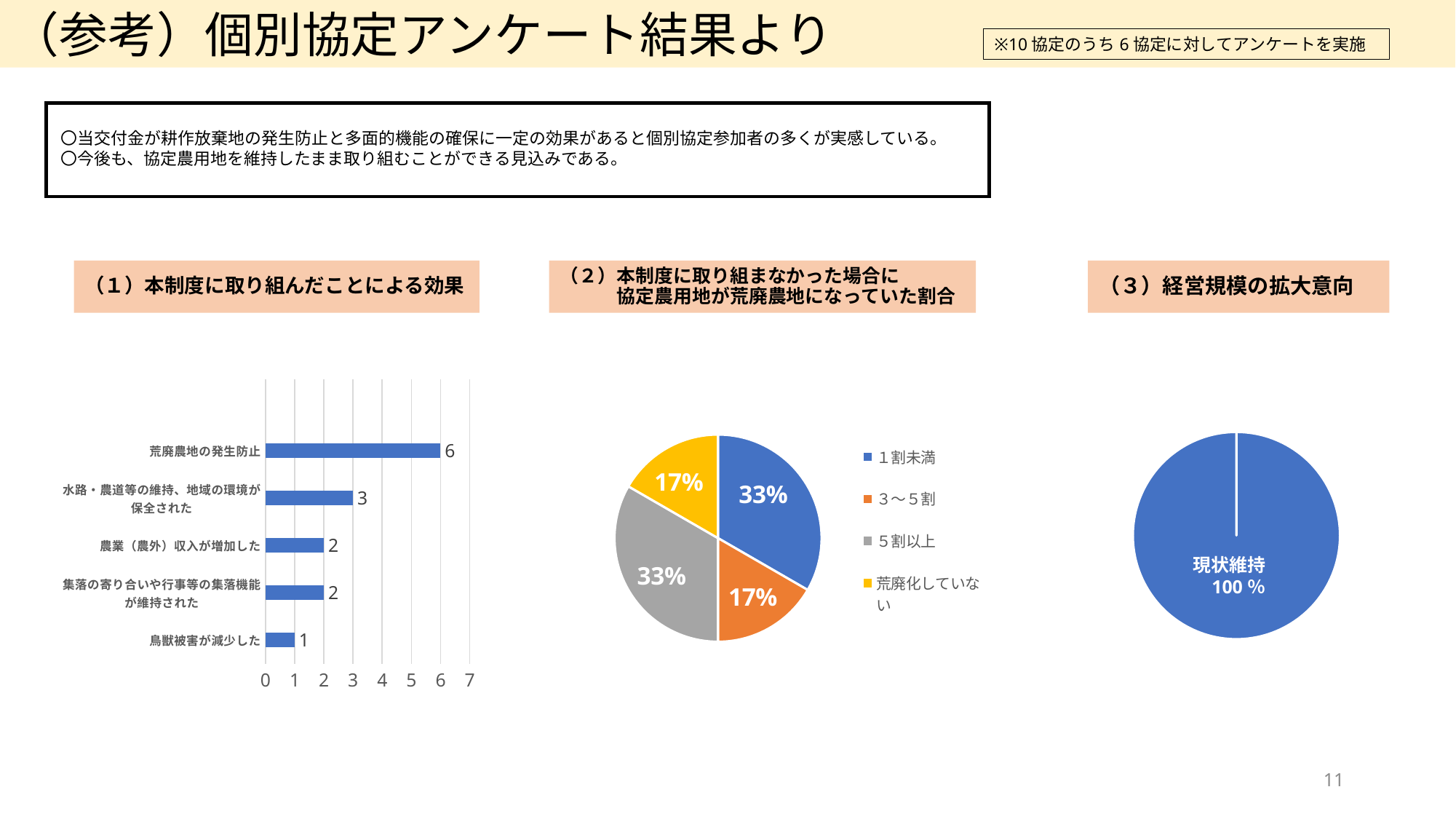
What kind of chart is chart (1) 本制度に取り組んだことによる効果? Bar chart In the chart (1) 本制度に取り組んだことによる効果, what is the value for 鳥獣被害が減少した? 1 In the chart (1) 本制度に取り組んだことによる効果, what is the value for 荒廃農地の発生防止? 6 In the pie chart (2) 本制度に取り組まなかった場合に協定農用地が荒廃農地になっていた割合, what share is 3〜5割? 17% In the pie chart (2) 本制度に取り組まなかった場合に協定農用地が荒廃農地になっていた割合, which is larger, 1割未満 or 荒廃化していない? 1割未満 In the chart (1) 本制度に取り組んだことによる効果, which category has the highest value? 荒廃農地の発生防止 In the chart (1) 本制度に取り組んだことによる効果, which category has the lowest value? 鳥獣被害が減少した In the pie chart (3) 経営規模の拡大意向, what share is 現状維持? 100% In the pie chart (2) 本制度に取り組まなかった場合に協定農用地が荒廃農地になっていた割合, what share is 5割以上? 33% In the pie chart (2) 本制度に取り組まなかった場合に協定農用地が荒廃農地になっていた割合, how many entries does the legend list? 4 In the chart (1) 本制度に取り組んだことによる効果, what is the difference between 荒廃農地の発生防止 and 水路・農道等の維持、地域の環境が保全された? 3 In the chart (1) 本制度に取り組んだことによる効果, how many categories are shown? 5